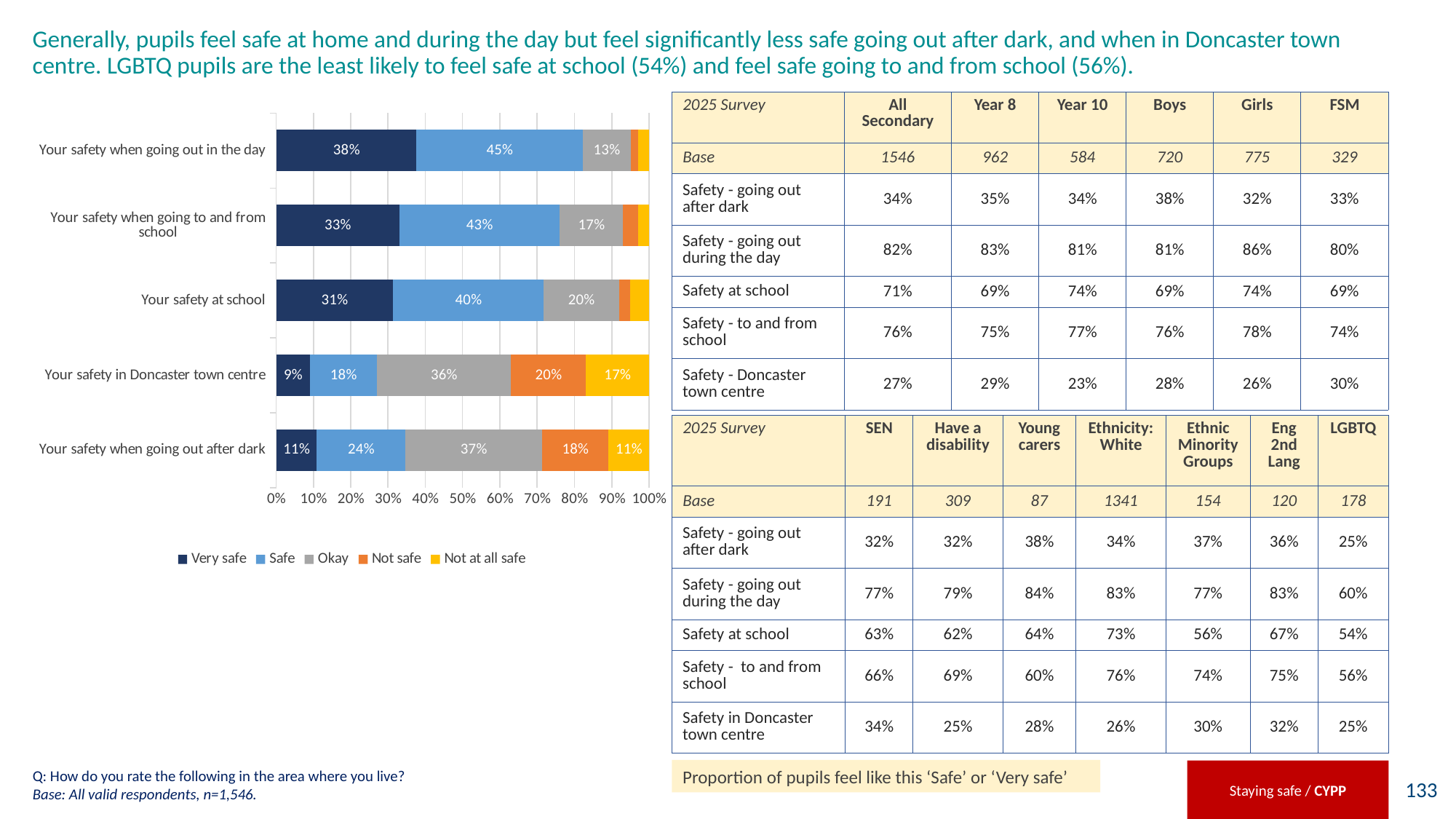
What colour represents the 'Very safe' series in the bar chart? Dark blue In the bar chart, what percentage of pupils said 'Very safe' for 'Your safety when going out in the day'? 38% In the bar chart, what is the combined 'Very safe' and 'Safe' percentage for 'Your safety in Doncaster town centre'? 27% In the bar chart, which category has the lowest 'Very safe' percentage? Your safety in Doncaster town centre In the bar chart, what is the difference between the 'Safe' percentage for 'going out in the day' (45%) and for 'going out after dark' (24%)? 21 percentage points How many categories (safety situations) are plotted in the bar chart? 5 In the bar chart, what percentage of pupils said 'Not at all safe' for 'Your safety when going out after dark'? 11% In the bar chart, which category has the highest 'Very safe' percentage? Your safety when going out in the day In the bar chart, which is larger: the 'Safe' percentage for 'Your safety at school' or for 'Your safety in Doncaster town centre'? Your safety at school How many series does the legend of the bar chart list? 5 In the bar chart, what percentage of pupils said 'Okay' for 'Your safety in Doncaster town centre'? 36% What kind of chart is shown on the left of the slide? Bar chart